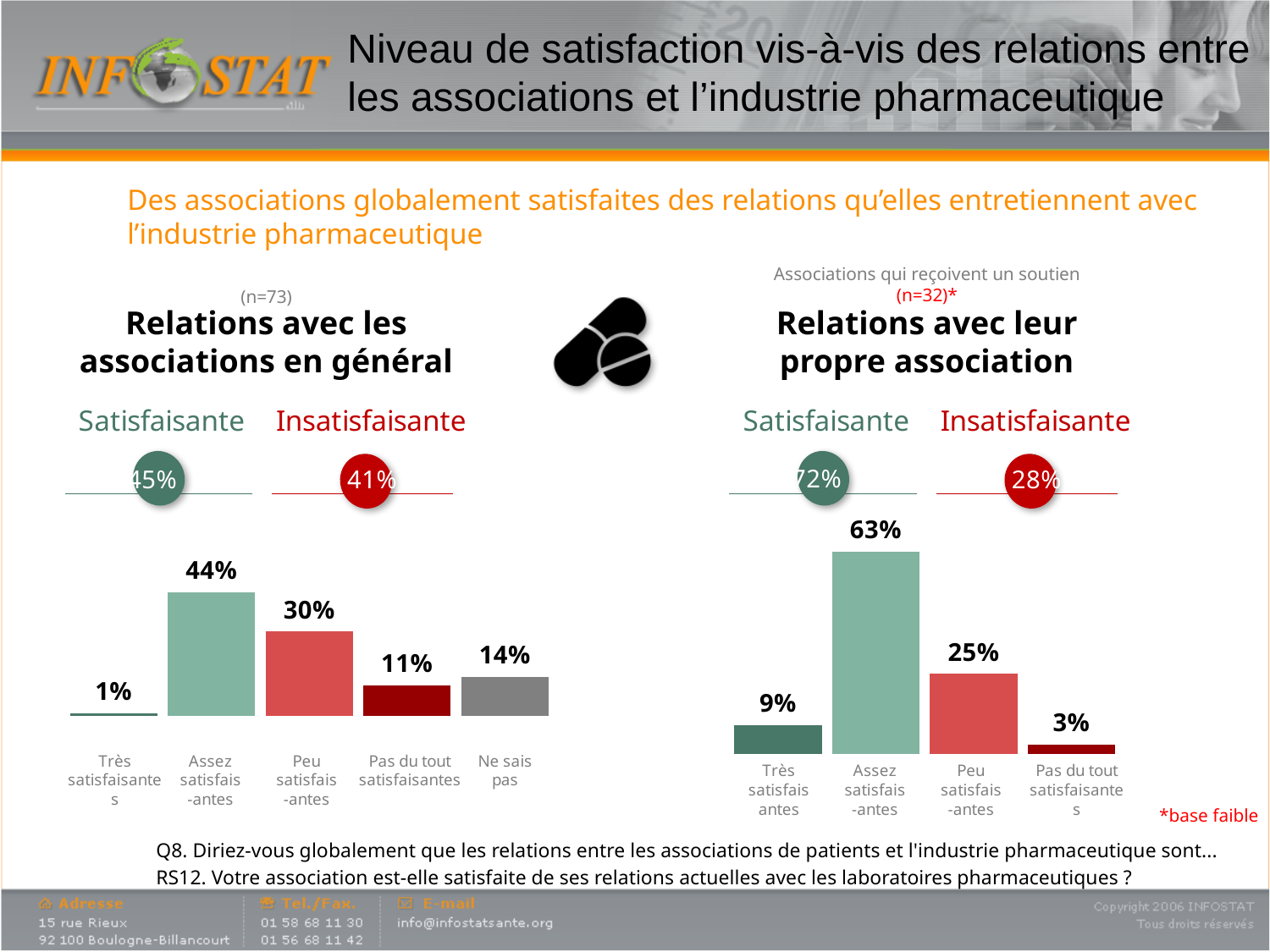
In the chart 'Relations avec les associations en général', which is larger: 'Pas du tout satisfaisantes' or 'Ne sais pas'? Ne sais pas In the chart 'Relations avec leur propre association', which category has the highest value? Assez satisfaisantes In the chart 'Relations avec leur propre association', what is the value for 'Peu satisfaisantes'? 25% In the chart 'Relations avec leur propre association', what is the overall 'Satisfaisante' percentage shown in the circle? 72% What is the sample size (n) indicated for the chart 'Relations avec les associations en général'? n=73 What kind of chart is 'Relations avec leur propre association'? Bar chart How many categories are shown in the chart 'Relations avec leur propre association'? 4 In the chart 'Relations avec les associations en général', what is the value for 'Assez satisfaisantes'? 44% How many categories are shown in the chart 'Relations avec les associations en général'? 5 In the chart 'Relations avec les associations en général', which category has the lowest value? Très satisfaisantes In the chart 'Relations avec leur propre association', what is the difference between 'Assez satisfaisantes' and 'Très satisfaisantes'? 54% In the chart 'Relations avec les associations en général', what is the difference between 'Assez satisfaisantes' and 'Peu satisfaisantes'? 14%